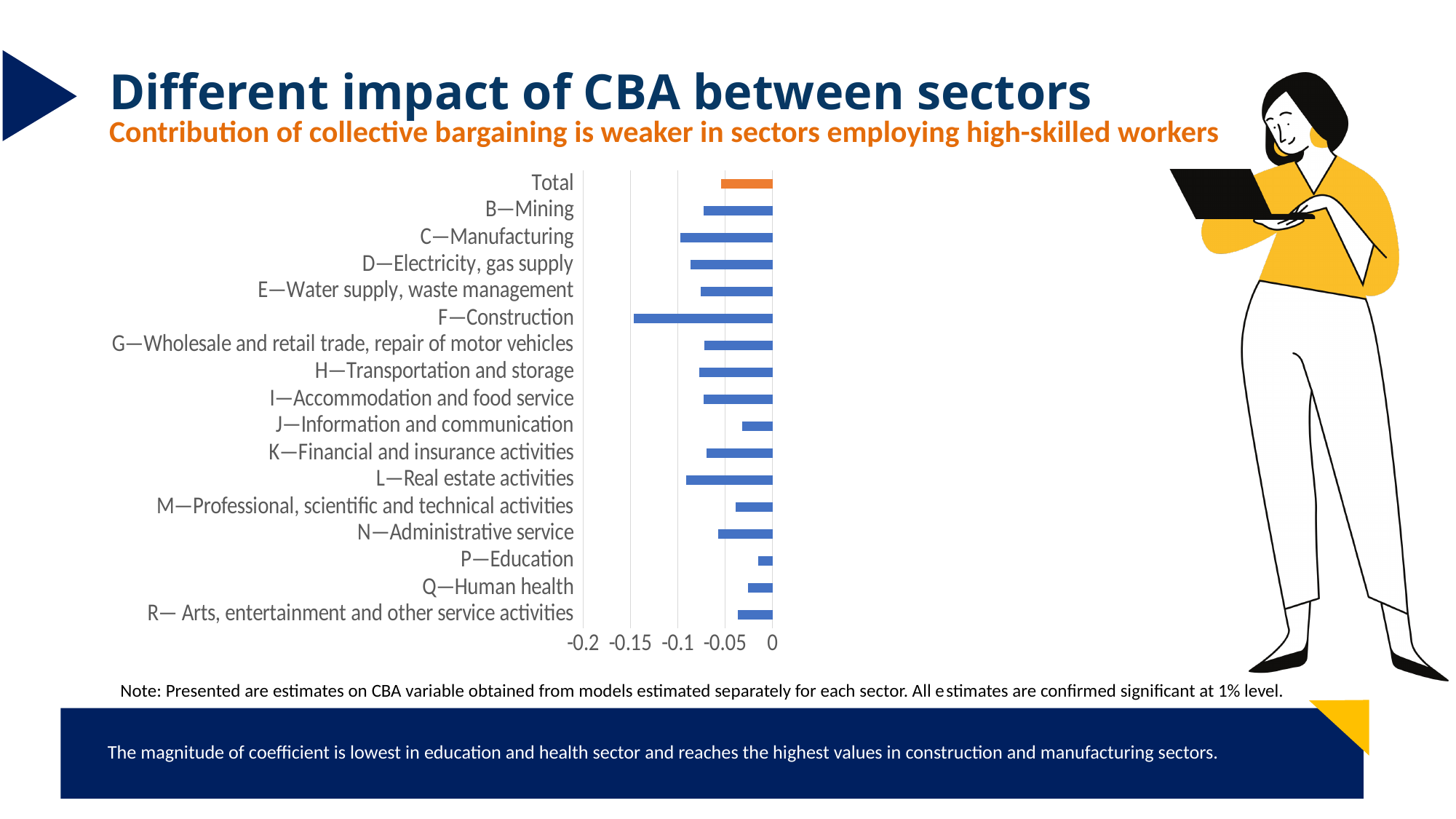
Which has the larger value, C—Manufacturing or F—Construction? C—Manufacturing What is the lowest value shown on the horizontal axis? -0.2 What colour is the bar for Total? Orange How many bars (categories) are plotted in the chart? 17 Is the value for J—Information and communication greater or less than -0.05? greater Is the value for F—Construction greater or less than -0.1? less Is the value for C—Manufacturing greater or less than -0.05? less What kind of chart is shown on the slide? Bar chart Which category has the lowest (most negative) value in the chart? F—Construction Which has the larger value, L—Real estate activities or J—Information and communication? J—Information and communication Which category has the highest value (closest to zero) in the chart? P—Education